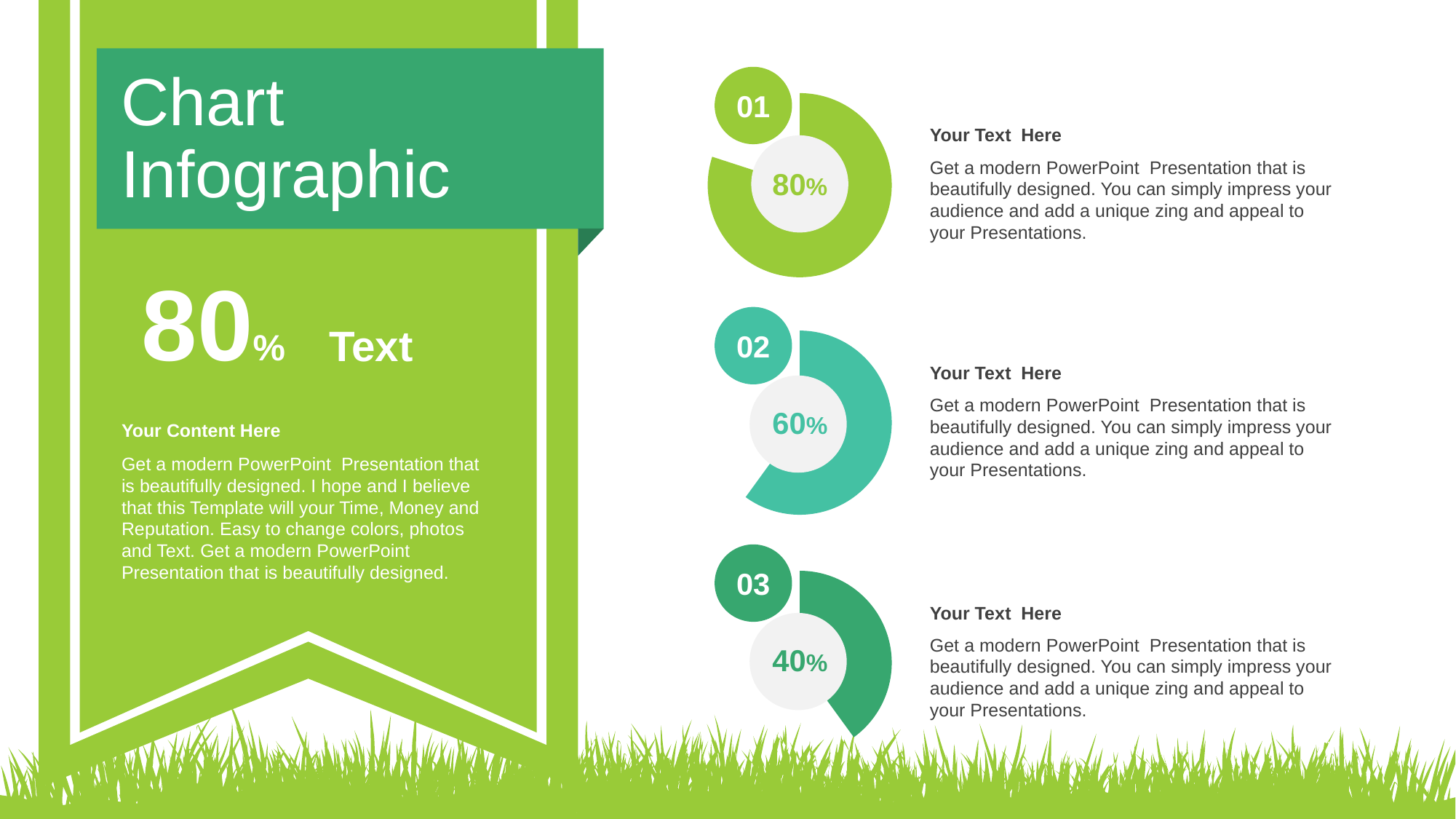
What percentage is shown in the donut chart labelled 01? 80% How many donut charts are shown on the right side of the slide? 3 Which of the three numbered donut charts shows the highest percentage? 01 Which shows a larger percentage, chart 01 or chart 02? chart 01 Which of the three numbered donut charts shows the lowest percentage? 03 What colour is the ring of the donut chart labelled 03? dark green What is the difference between the percentage in chart 01 and the percentage in chart 03? 40% What is the difference between the percentage in chart 02 and the percentage in chart 03? 20% Do the percentages rise or fall going from chart 01 down to chart 03? fall What percentage is shown in the donut chart labelled 03? 40% What percentage is shown in the donut chart labelled 02? 60% What kind of chart is used for the three numbered items on the right of the slide? donut chart